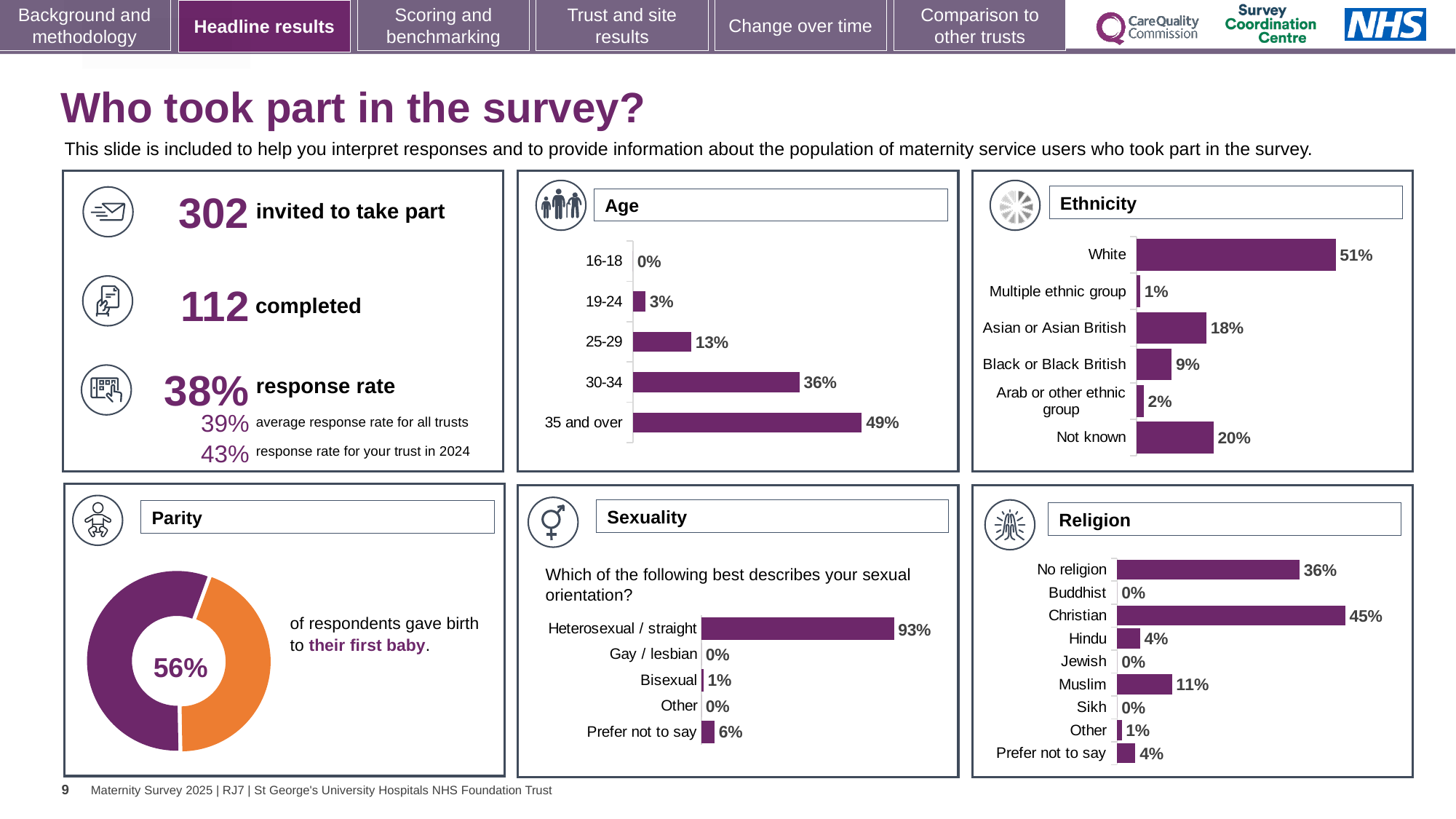
In the Religion chart, which is larger: Christian or No religion? Christian In the Age chart, what percentage of respondents were aged 35 and over? 49% In the Age chart, what is the difference between the 30-34 and 25-29 percentages? 23% In the Parity chart, what percentage of respondents gave birth to their first baby? 56% In the Sexuality chart, what percentage of respondents answered Prefer not to say? 6% In the Religion chart, what percentage of respondents were Muslim? 11% In the Religion chart, how many categories are listed? 9 In the Ethnicity chart, what percentage of respondents were Asian or Asian British? 18% In the Age chart, which age group has the highest percentage? 35 and over In the Ethnicity chart, how many categories are shown? 6 What kind of chart is used in the Parity panel? Doughnut chart In the Ethnicity chart, which category has the highest percentage? White